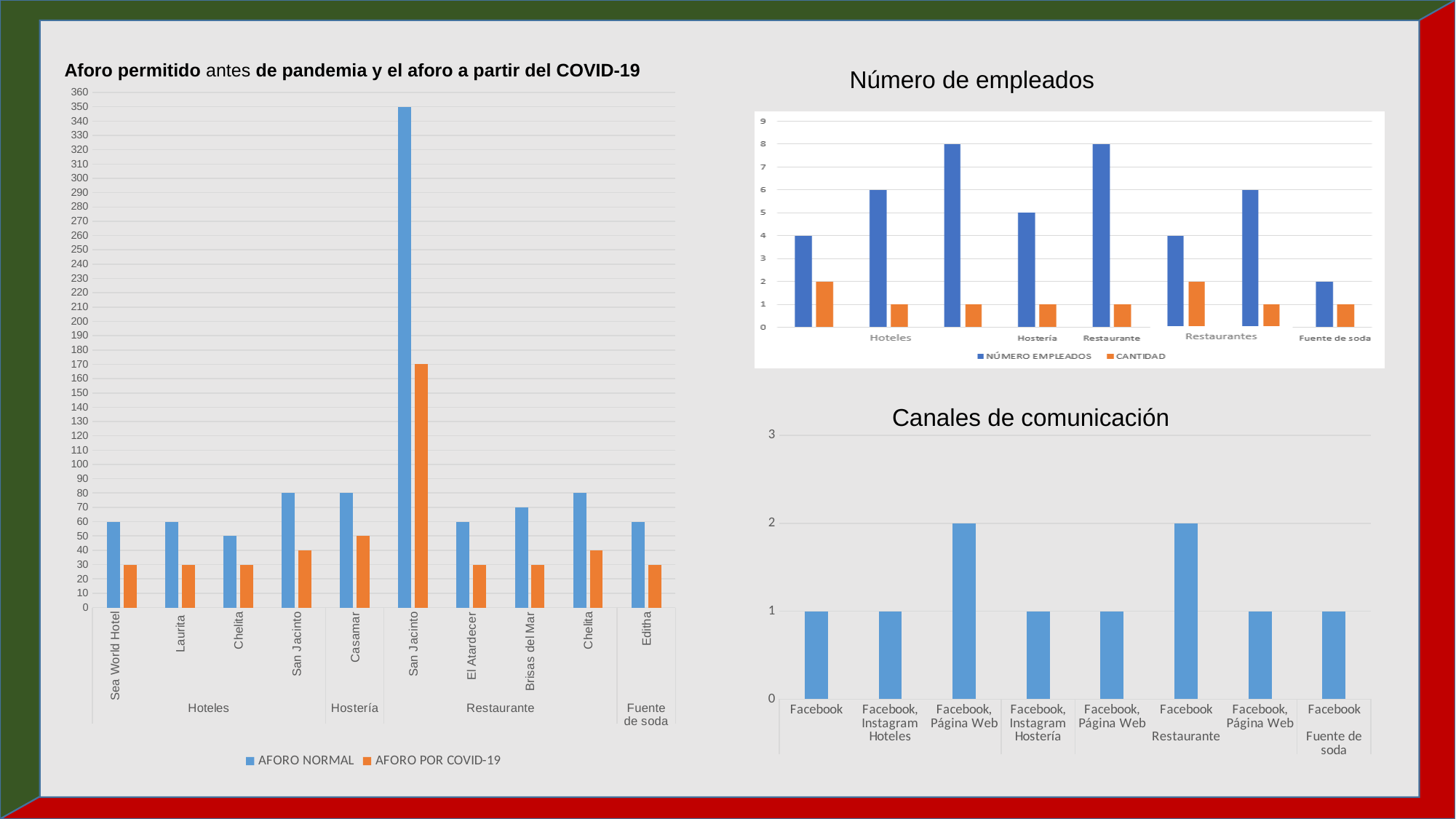
In the chart 'Aforo permitido antes de pandemia y el aforo a partir del COVID-19', which category has the highest AFORO NORMAL value? San Jacinto (Restaurante) In the chart 'Canales de comunicación', what is the value for 'Facebook, Página Web' under Hoteles? 2 In the chart 'Aforo permitido antes de pandemia y el aforo a partir del COVID-19', how many categories are shown on the x axis? 10 In the chart 'Aforo permitido antes de pandemia y el aforo a partir del COVID-19', is the AFORO NORMAL value for Laurita greater or less than the AFORO NORMAL value for Casamar? less In the chart 'Número de empleados', what are the two series listed in the legend? NÚMERO EMPLEADOS and CANTIDAD In the chart 'Aforo permitido antes de pandemia y el aforo a partir del COVID-19', what is the AFORO POR COVID-19 value for the San Jacinto restaurant? 170 What kind of chart is 'Número de empleados'? bar chart In the chart 'Aforo permitido antes de pandemia y el aforo a partir del COVID-19', how many series does the legend list? 2 In the chart 'Canales de comunicación', how many bars are plotted? 8 In the chart 'Número de empleados', what is the highest value reached by the NÚMERO EMPLEADOS series? 8 In the chart 'Aforo permitido antes de pandemia y el aforo a partir del COVID-19', what is the difference between the AFORO NORMAL and AFORO POR COVID-19 values for Brisas del Mar? 40 In the chart 'Aforo permitido antes de pandemia y el aforo a partir del COVID-19', what is the AFORO NORMAL value for Casamar? 80